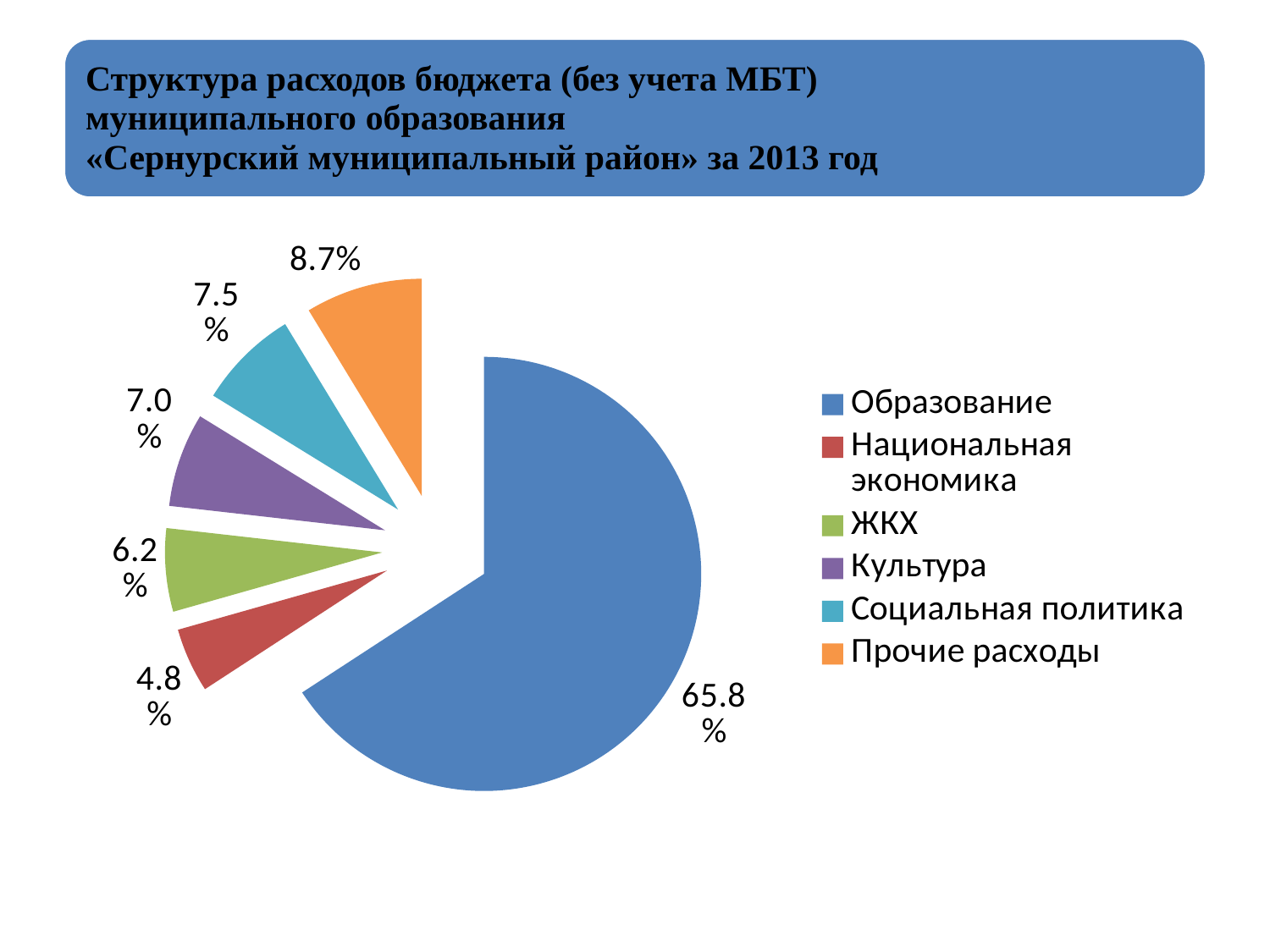
Which colour represents Культура in the legend? Purple How many categories does the pie chart have? 6 What is the combined share of Национальная экономика and Культура? 11.8% What share of budget expenditures does Образование account for? 65.8% Which category has the smallest share of the pie? Национальная экономика What is the value shown for Прочие расходы? 8.7% Which is larger, the share for Социальная политика or the share for ЖКХ? Социальная политика What is the value shown for ЖКХ? 6.2% Which category has the largest share of the pie? Образование What is the difference between the shares of Прочие расходы and Культура? 1.7% What type of chart is shown on the slide? Pie chart What is the value shown for Социальная политика? 7.5%